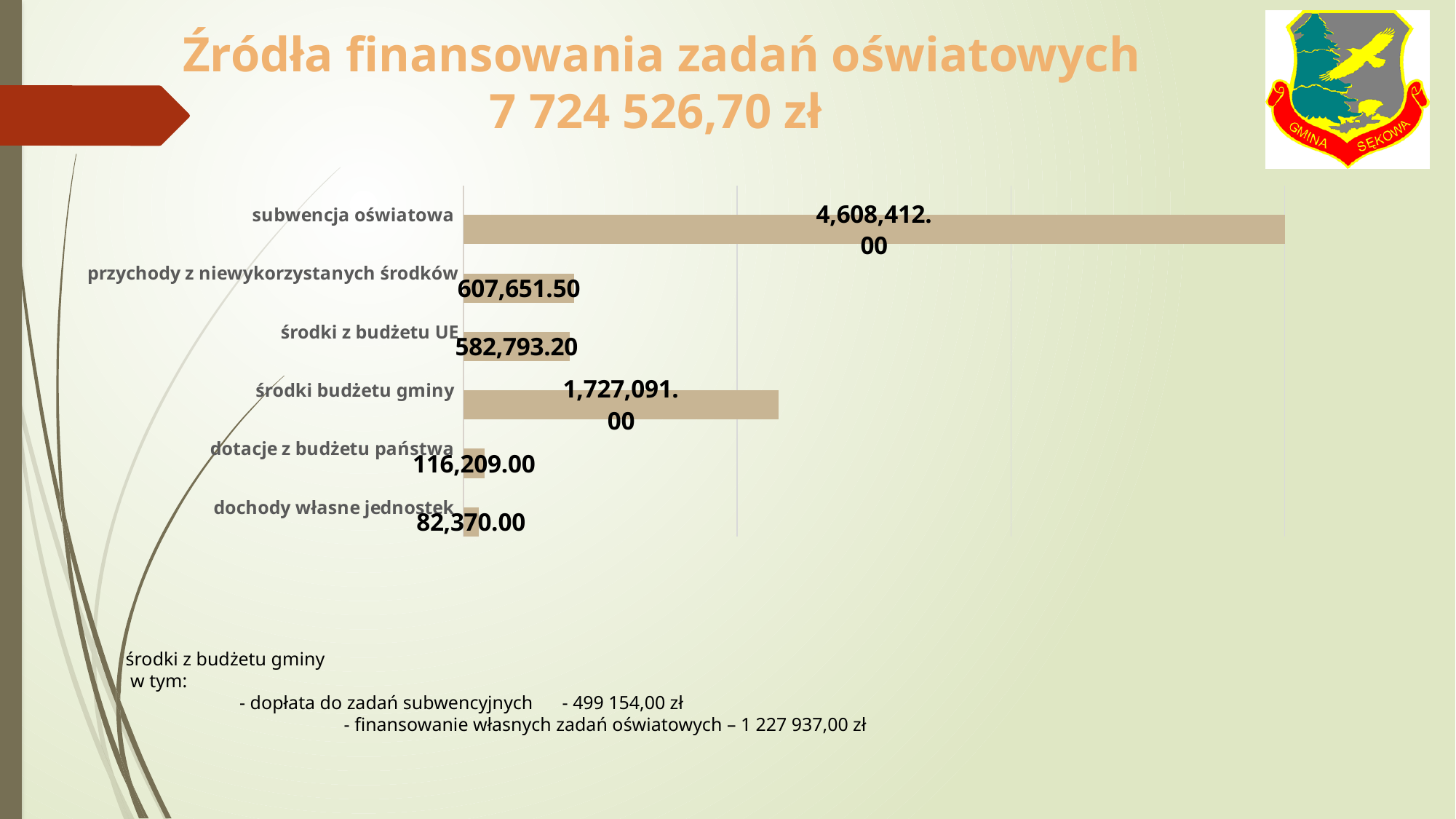
What is the difference between dotacje z budżetu państwa and dochody własne jednostek? 33,839.00 What total amount is given in the slide title? 7 724 526,70 zł What is the value for środki z budżetu UE? 582,793.20 What is the value for środki budżetu gminy? 1,727,091.00 How many categories are shown in the chart? 6 Which category has the highest value? subwencja oświatowa What is the value for subwencja oświatowa? 4,608,412.00 What is the difference between subwencja oświatowa and środki budżetu gminy? 2,881,321.00 Which is larger: przychody z niewykorzystanych środków or środki z budżetu UE? przychody z niewykorzystanych środków What is the value for dochody własne jednostek? 82,370.00 What kind of chart is shown on the slide? bar chart Which category has the lowest value? dochody własne jednostek